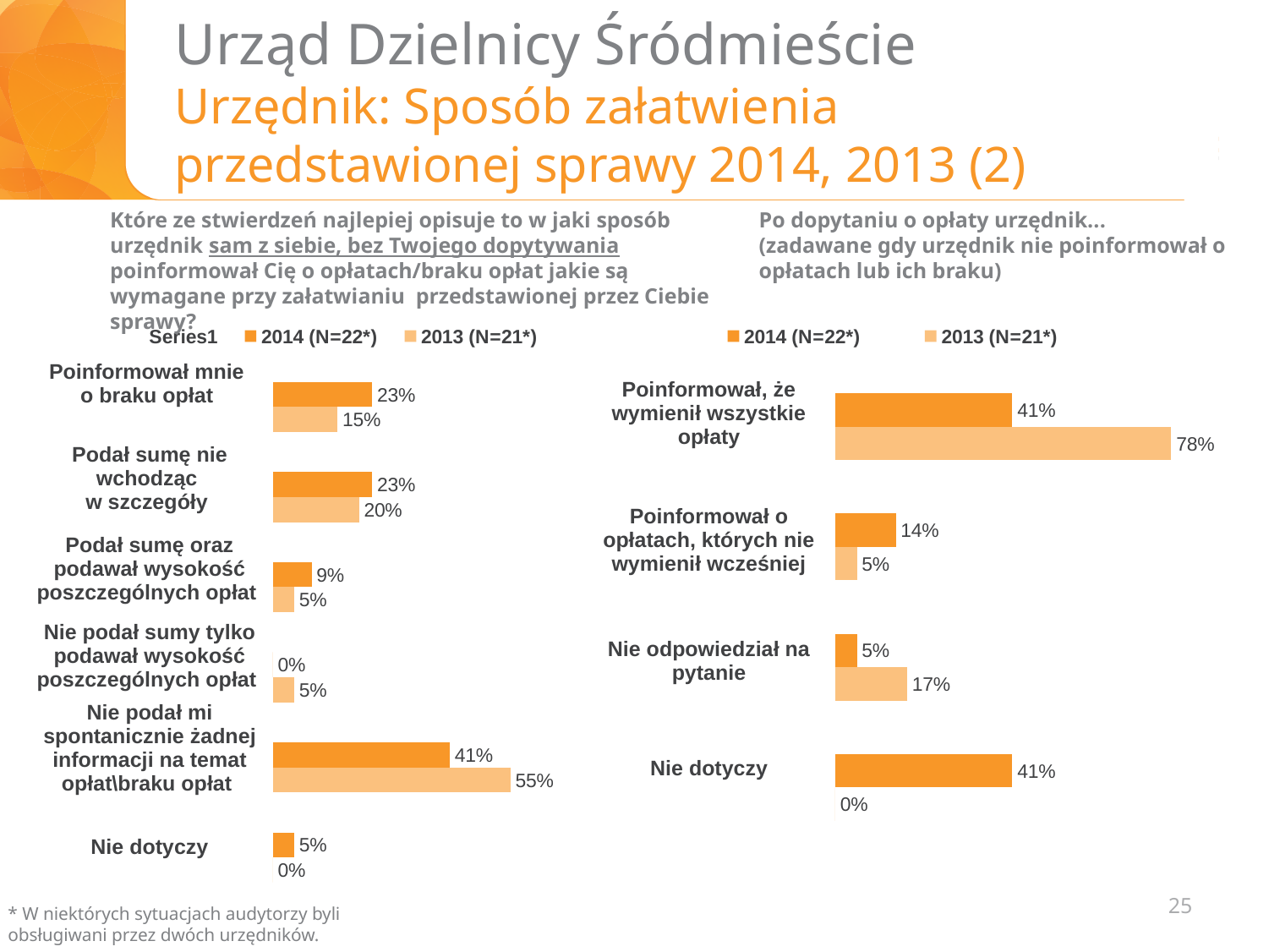
In the right chart, what is the difference between the 2013 and 2014 values for "Poinformował, że wymienił wszystkie opłaty"? 37% What type of chart is the right chart? Bar chart In the left chart, what is the 2014 value for "Nie podał mi spontanicznie żadnej informacji na temat opłat\braku opłat"? 41% In the left chart, what is the difference between the 2013 and 2014 values for "Nie podał mi spontanicznie żadnej informacji na temat opłat\braku opłat"? 14% In the left chart, which category has the highest 2013 value? Nie podał mi spontanicznie żadnej informacji na temat opłat\braku opłat In the left chart, what is the 2013 value for "Poinformował mnie o braku opłat"? 15% In the right chart, for "Nie odpowiedział na pytanie", which year has the larger value, 2014 or 2013? 2013 How many categories are shown in the right chart? 4 In the right chart, what is the 2013 value for "Poinformował, że wymienił wszystkie opłaty"? 78% How many categories are shown in the left chart? 6 In the right chart, which category has the lowest 2013 value? Nie dotyczy In the right chart, what is the 2014 value for "Poinformował o opłatach, których nie wymienił wcześniej"? 14%